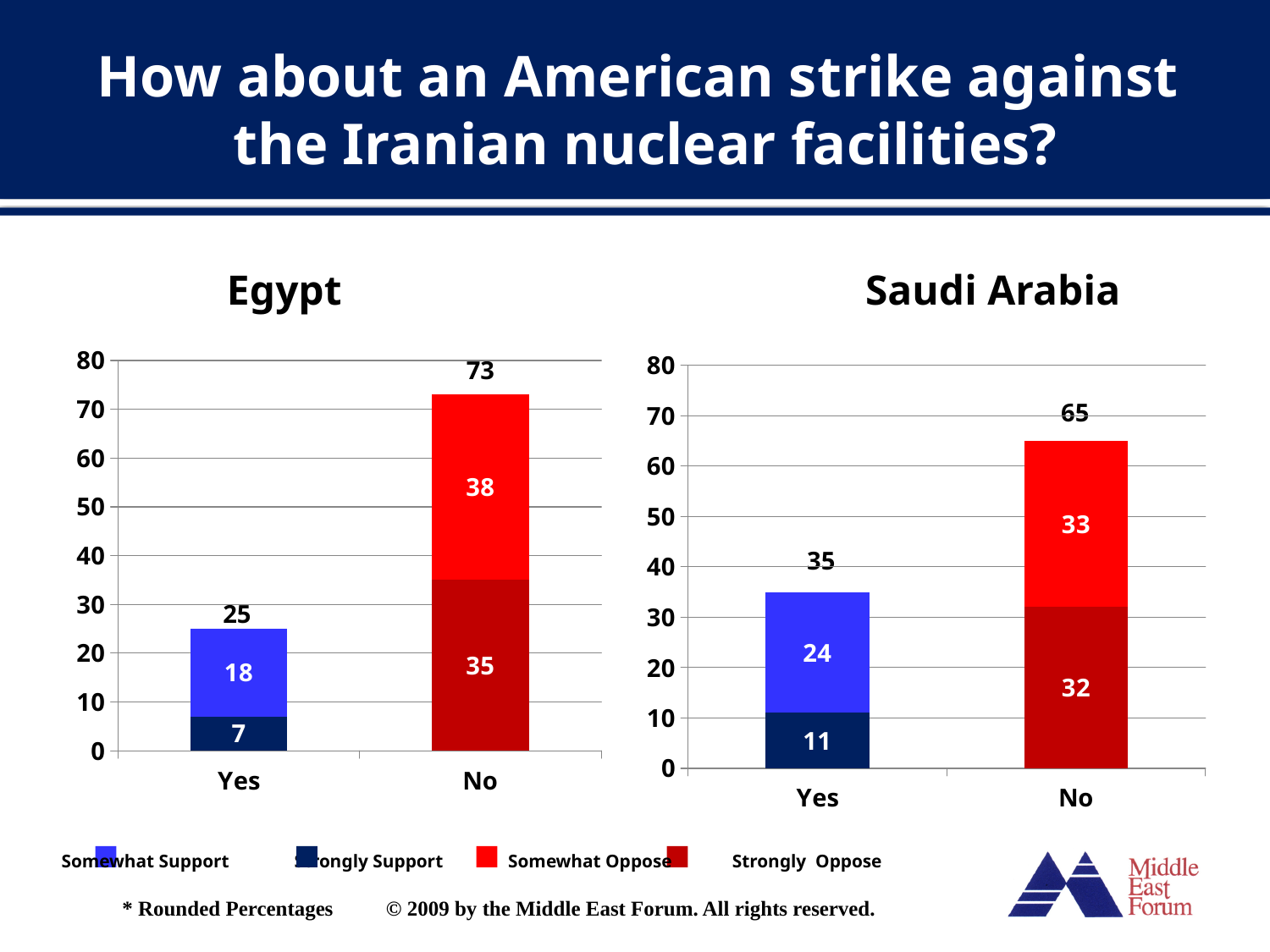
Which legend entry is shown in dark red? Strongly Oppose In the Egypt chart, what is the difference between the No total and the Yes total? 48 How many series does the legend list? 4 In the Egypt chart, what is the Somewhat Support value for Yes? 18 In the Egypt chart, what is the Strongly Oppose value for No? 35 In the Egypt chart, is the total for Yes greater or less than 30? less In the Saudi Arabia chart, what is the total value of the Yes bar? 35 In the Saudi Arabia chart, which bar is taller, Yes or No? No In the Saudi Arabia chart, what is the Somewhat Oppose value for No? 33 In the Egypt chart, what is the total value of the No bar? 73 What kind of chart is the Saudi Arabia chart? Stacked bar chart In the Saudi Arabia chart, what is the Strongly Support value for Yes? 11